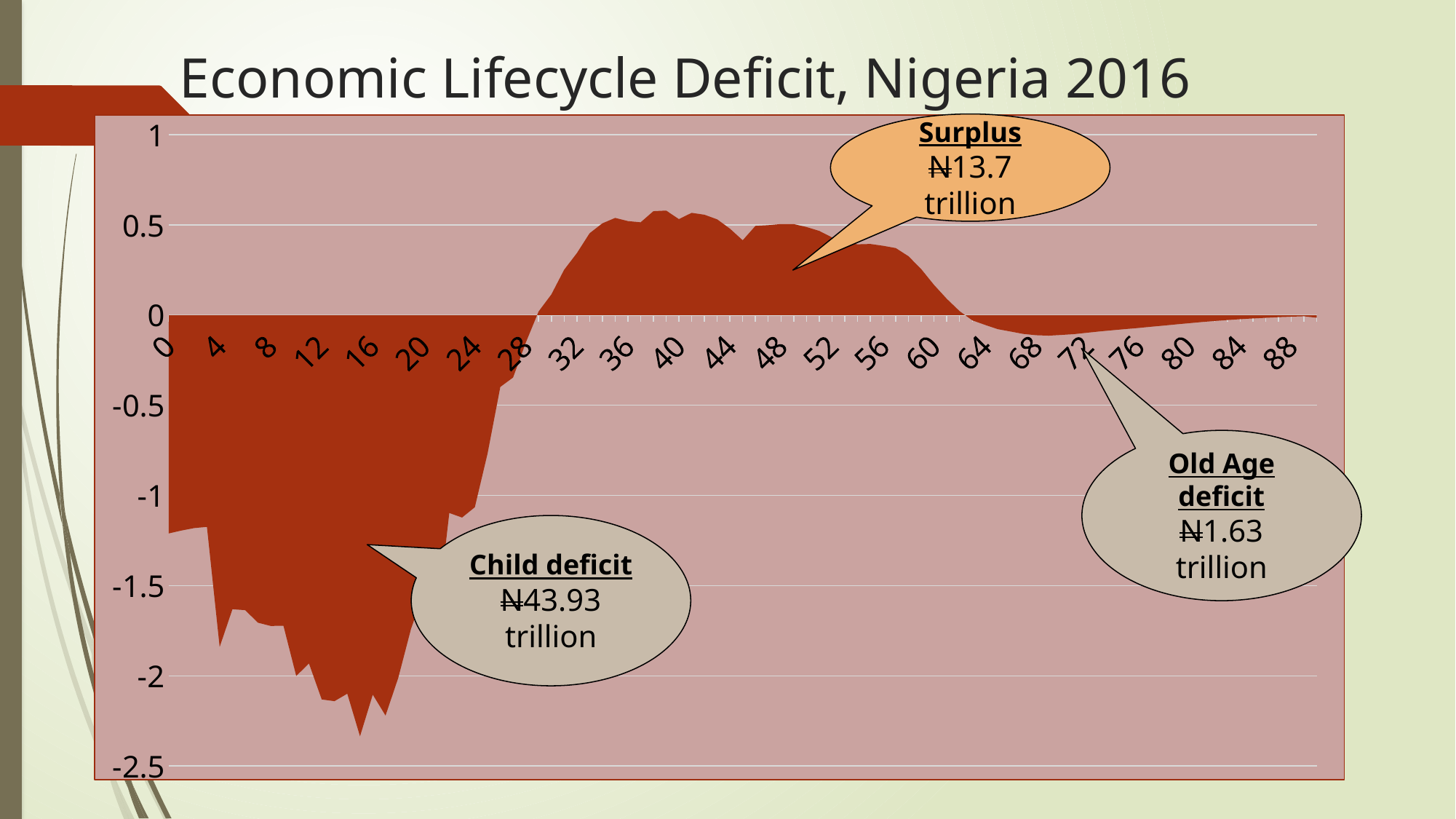
Is the value at age 44 greater or less than 0? greater What is the lowest value shown on the y axis? -2.5 Which is larger, the Child deficit or the Old Age deficit? Child deficit What kind of chart is shown on the slide? area chart What is the title of the chart? Economic Lifecycle Deficit, Nigeria 2016 Is the value at age 8 greater or less than -1? less What is the value of the Surplus shown in the callout? ₦13.7 trillion Is the value at age 16 greater or less than -2? less What is the value of the Old Age deficit shown in the callout? ₦1.63 trillion What is the difference between the Child deficit and the Old Age deficit? ₦42.3 trillion What is the value of the Child deficit shown in the callout? ₦43.93 trillion Do the values rise or fall along the x axis between age 16 and age 28? rise